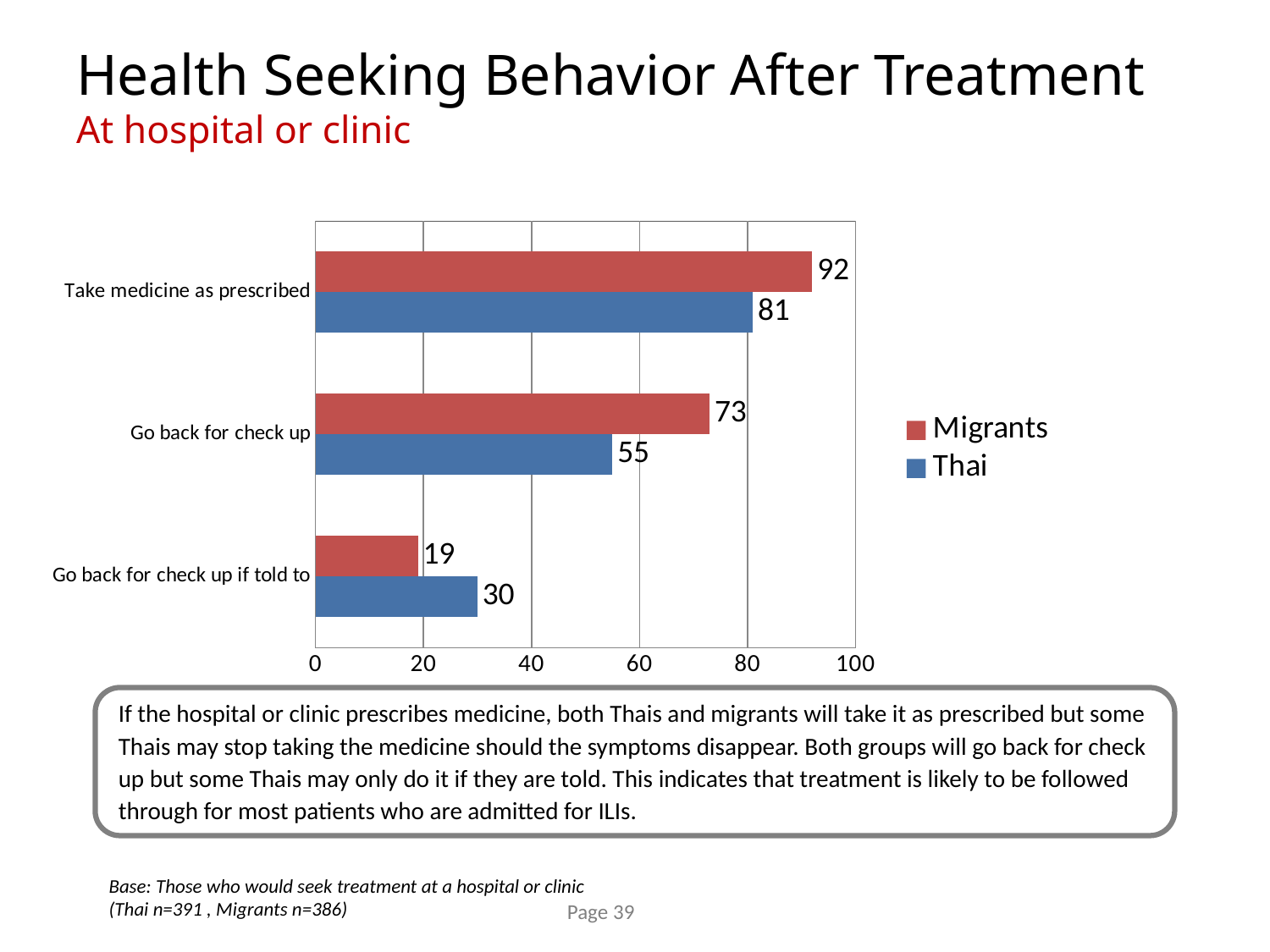
What kind of chart is shown on the slide? Bar chart What is the value for Thai for "Go back for check up if told to"? 30 For "Go back for check up if told to", which group has the larger value, Migrants or Thai? Thai Which category has the lowest value for Thai? Go back for check up if told to What is the value for Migrants for "Take medicine as prescribed"? 92 How many series does the legend list? 2 How many categories are shown on the chart? 3 What is the value for Thai for "Go back for check up"? 55 What is the difference between the Migrants and Thai values for "Go back for check up"? 18 Is the Migrants value for "Go back for check up" greater or less than 60? greater Which category has the highest value for Migrants? Take medicine as prescribed What is the difference between the Migrants and Thai values for "Take medicine as prescribed"? 11